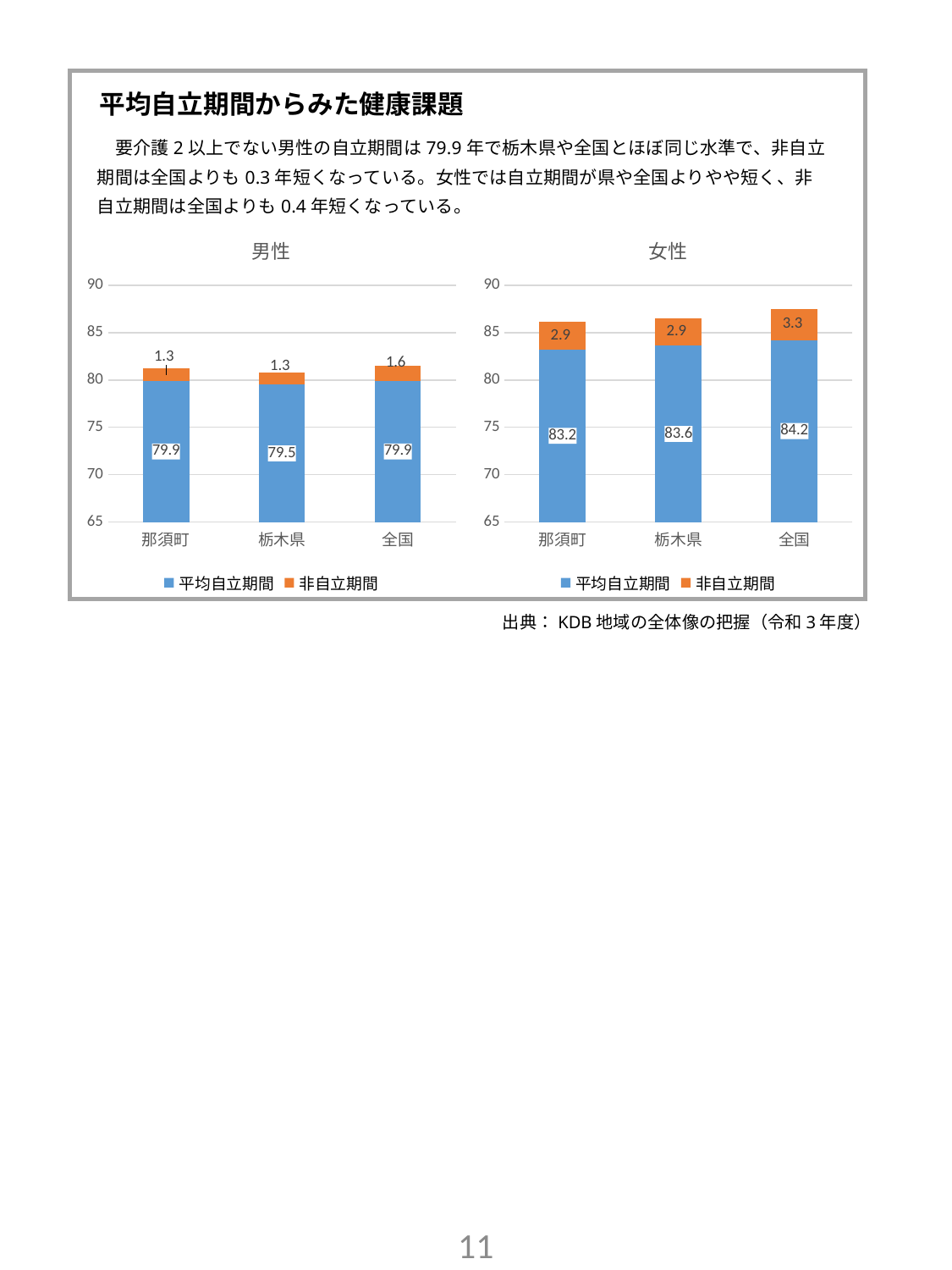
In the 女性 chart, what is the difference between the 平均自立期間 values for 全国 and 那須町? 1.0 In the 女性 chart, what is the total of the stacked bar for 那須町? 86.1 What kind of chart is the 男性 chart? Stacked bar chart How many series does the legend of the 女性 chart list? 2 In the 男性 chart, what is the 非自立期間 value for 全国? 1.6 In the 男性 chart, is the 非自立期間 value larger for 全国 or for 栃木県? 全国 In the 女性 chart, which category has the highest 平均自立期間 value? 全国 In the 男性 chart, what is the total of the stacked bar for 全国? 81.5 In the 男性 chart, what is the 平均自立期間 value for 那須町? 79.9 In the 女性 chart, what is the 非自立期間 value for 全国? 3.3 In the 女性 chart, what is the 平均自立期間 value for 栃木県? 83.6 In the 男性 chart, which category has the lowest 平均自立期間 value? 栃木県